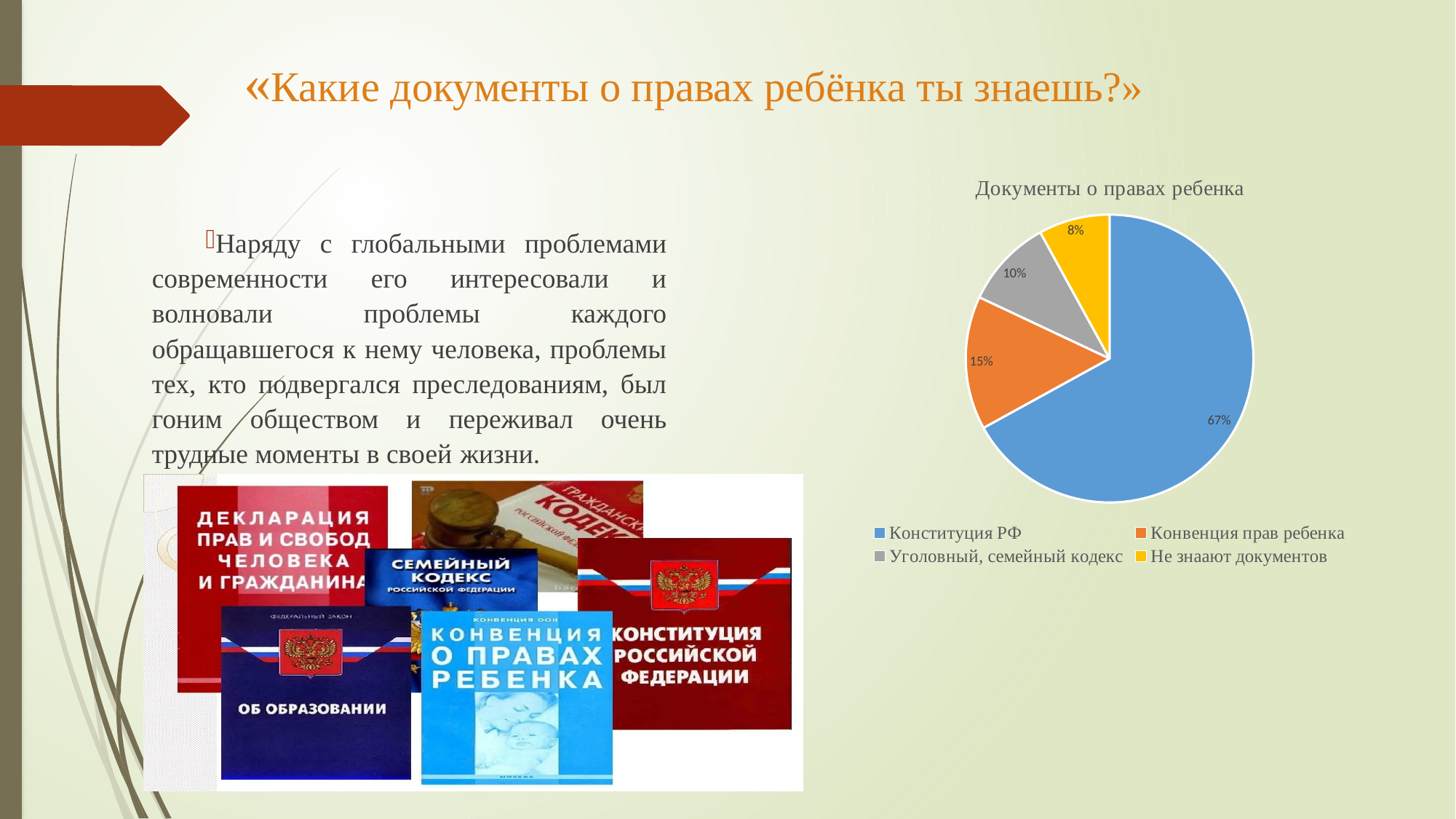
Which category has the smallest slice of the pie? Не знаают документов What share of the pie does Не знаают документов have? 8% What type of chart is shown on the slide? pie chart What share of the pie does Конституция РФ have? 67% What share of the pie does Конвенция прав ребенка have? 15% What is the title of the chart? Документы о правах ребенка Which is larger: the slice for Уголовный, семейный кодекс or the slice for Не знаают документов? Уголовный, семейный кодекс What share of the pie does Уголовный, семейный кодекс have? 10% How many categories does the legend list? 4 What is the difference in percentage points between Конституция РФ and Конвенция прав ребенка? 52 What colour is the slice for Конвенция прав ребенка? orange Which category has the largest slice of the pie? Конституция РФ